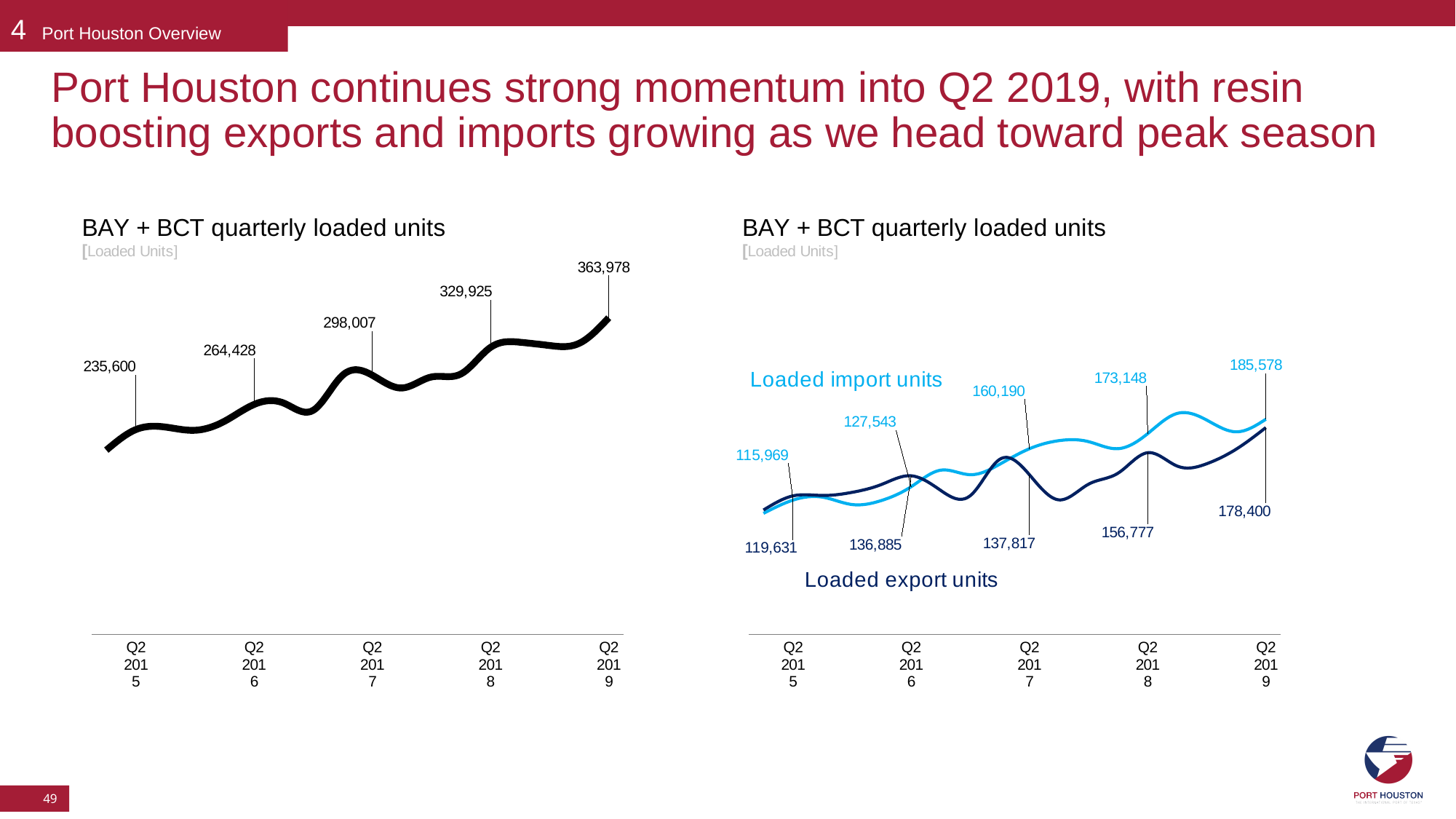
In the left chart, do the values rise or fall from Q2 2015 to Q2 2019? rise What type of chart is the left chart? line chart In the left chart, which quarter has the lowest value? Q2 2015 In the right chart, what is the value of loaded export units for Q2 2018? 156,777 In the left chart, what is the value for Q2 2015? 235,600 In the left chart, what is the difference between the Q2 2019 and Q2 2015 values? 128,378 In the left chart, what is the value for Q2 2019? 363,978 In the right chart, what is the difference between loaded import units and loaded export units in Q2 2019? 7,178 In the right chart, what is the value of loaded import units for Q2 2017? 160,190 How many series are plotted in the right chart? 2 In the right chart, which is larger for Q2 2019: loaded import units or loaded export units? Loaded import units